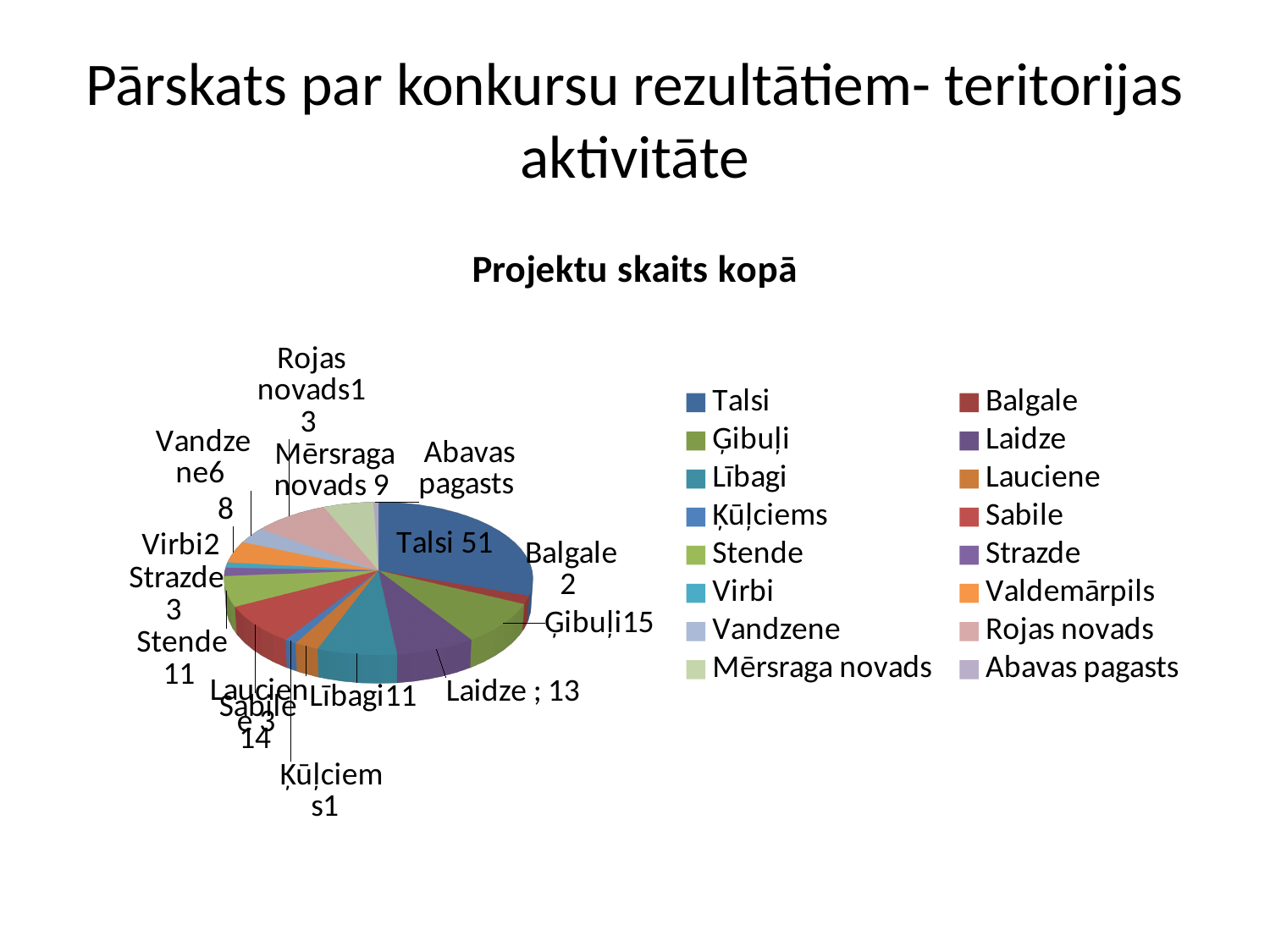
Which is larger, the value for Ģibuļi or the value for Laidze? Ģibuļi What is the difference between the values for Talsi and Sabile? 37 What is the value for Rojas novads? 13 What is the value for Talsi? 51 Which category has the largest slice of the pie? Talsi What is the value for Sabile? 14 How many entries does the chart legend list? 16 Which category has the smallest value shown? Ķūļciems What is the value for Mērsraga novads? 9 What kind of chart is shown on the slide? pie chart What is the title of the chart? Projektu skaits kopā What is the difference between the values for Vandzene and Virbi? 4